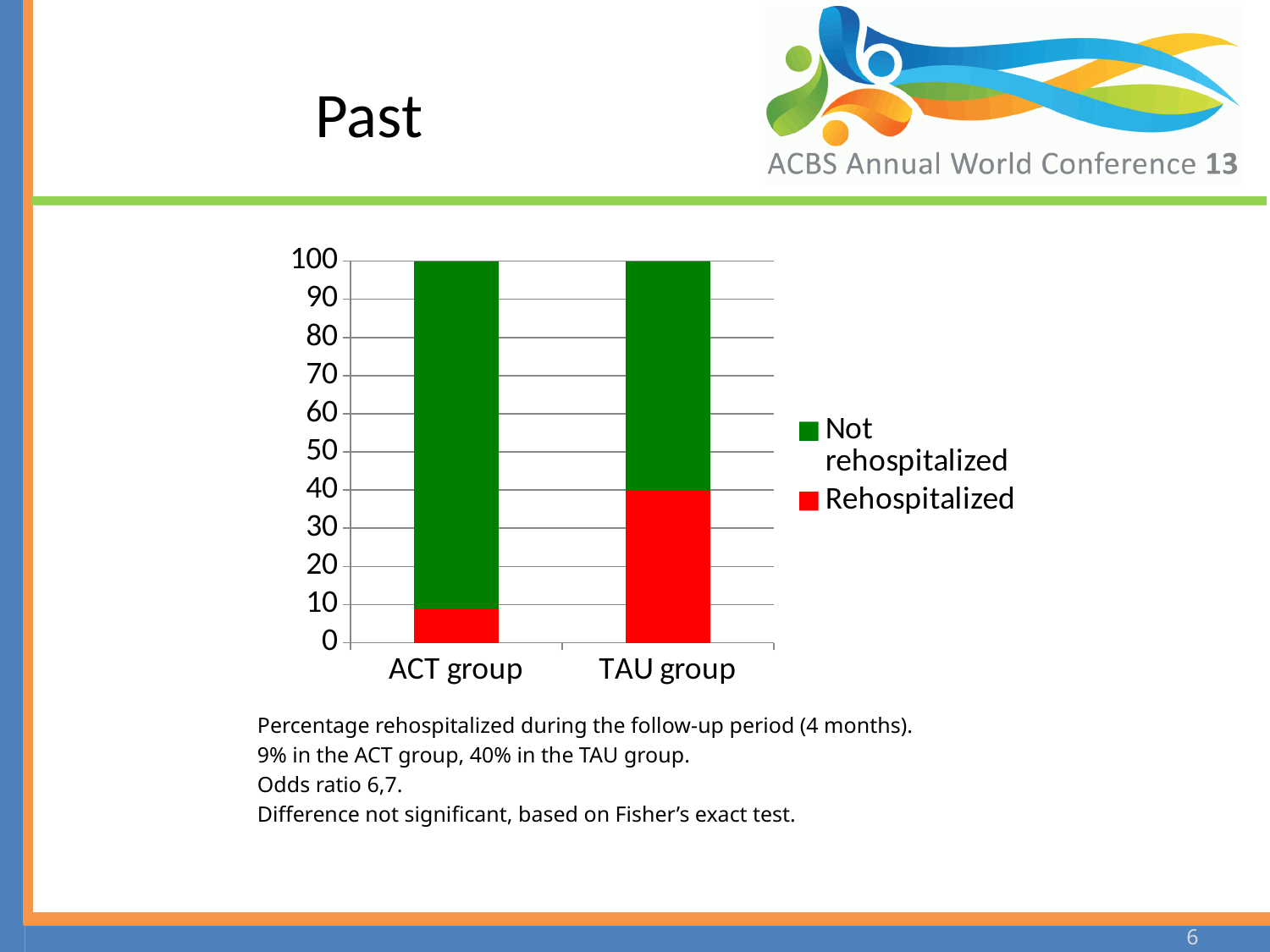
What kind of chart is shown on the slide? Stacked bar chart Which group has the lower rehospitalized percentage? ACT group Is the 'Not rehospitalized' value for the TAU group greater or less than 50? greater What percentage of the TAU group was rehospitalized? 40% Which group has the higher rehospitalized percentage? TAU group What is the difference between the rehospitalized percentage of the TAU group and that of the ACT group? 31% Is the 'Not rehospitalized' share larger for the ACT group or the TAU group? ACT group What is the total height of each stacked bar on the y axis? 100 How many groups (categories) are shown on the x axis of the chart? 2 Which colour represents the 'Rehospitalized' series in the chart? Red How many series does the chart's legend list? 2 What percentage of the ACT group was rehospitalized? 9%